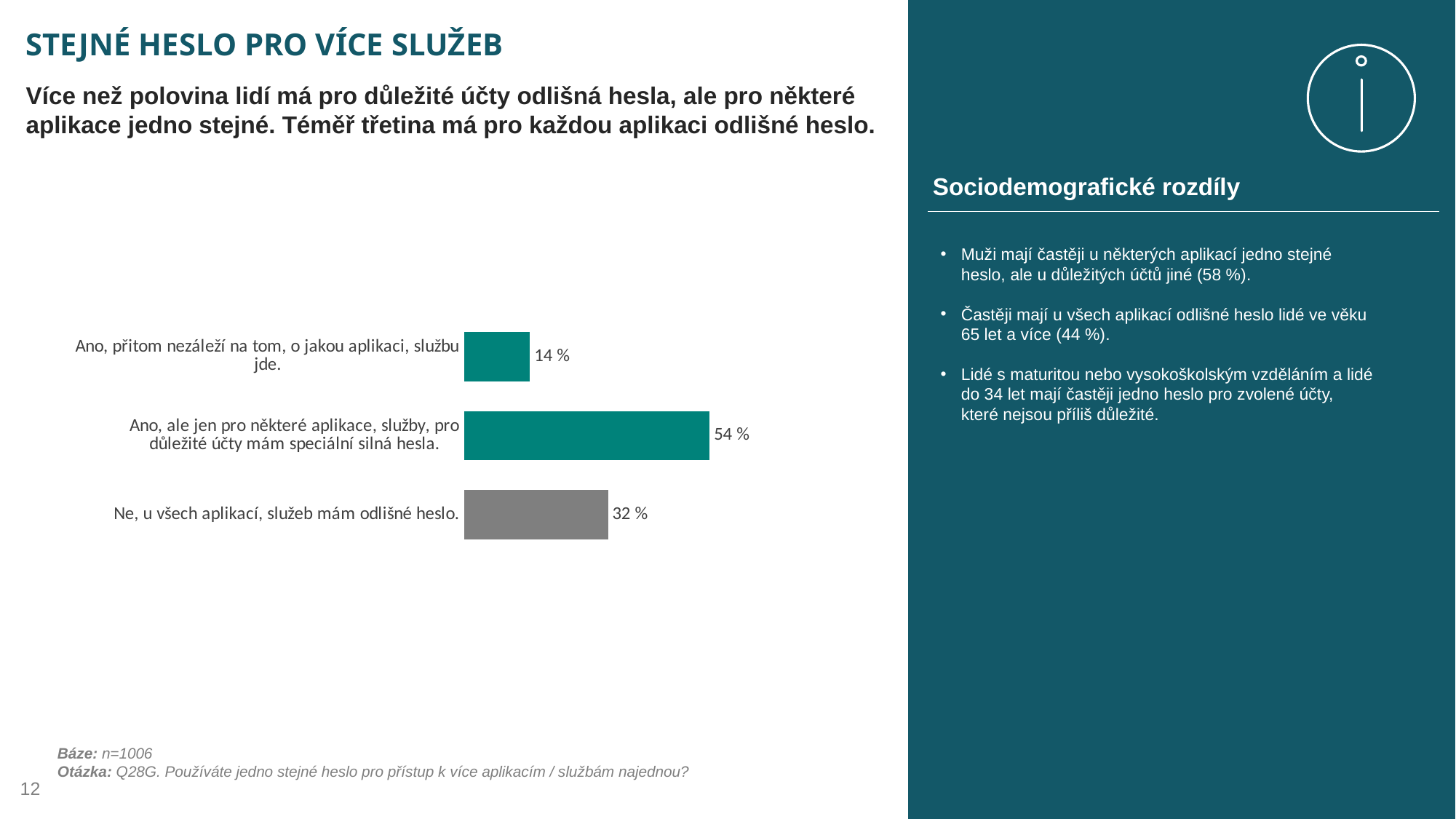
How many categories are shown in the chart? 3 What is the difference between the value for "Ne, u všech aplikací, služeb mám odlišné heslo." and the value for "Ano, přitom nezáleží na tom, o jakou aplikaci, službu jde."? 18 % Which category has the lowest value? Ano, přitom nezáleží na tom, o jakou aplikaci, službu jde. Which bar in the chart is coloured grey rather than teal? Ne, u všech aplikací, služeb mám odlišné heslo. What value is shown for the category "Ne, u všech aplikací, služeb mám odlišné heslo."? 32 % What value is shown for the category "Ano, přitom nezáleží na tom, o jakou aplikaci, službu jde."? 14 % What is the difference between the value for "Ano, ale jen pro některé aplikace..." and the value for "Ne, u všech aplikací, služeb mám odlišné heslo."? 22 % Which category has the highest value? Ano, ale jen pro některé aplikace, služby, pro důležité účty mám speciální silná hesla. What kind of chart is shown on the slide? Bar chart What is the title of the slide containing the chart? STEJNÉ HESLO PRO VÍCE SLUŽEB Which is larger: the value for "Ne, u všech aplikací, služeb mám odlišné heslo." or the value for "Ano, přitom nezáleží na tom, o jakou aplikaci, službu jde."? Ne, u všech aplikací, služeb mám odlišné heslo. What value is shown for the category "Ano, ale jen pro některé aplikace, služby, pro důležité účty mám speciální silná hesla."? 54 %